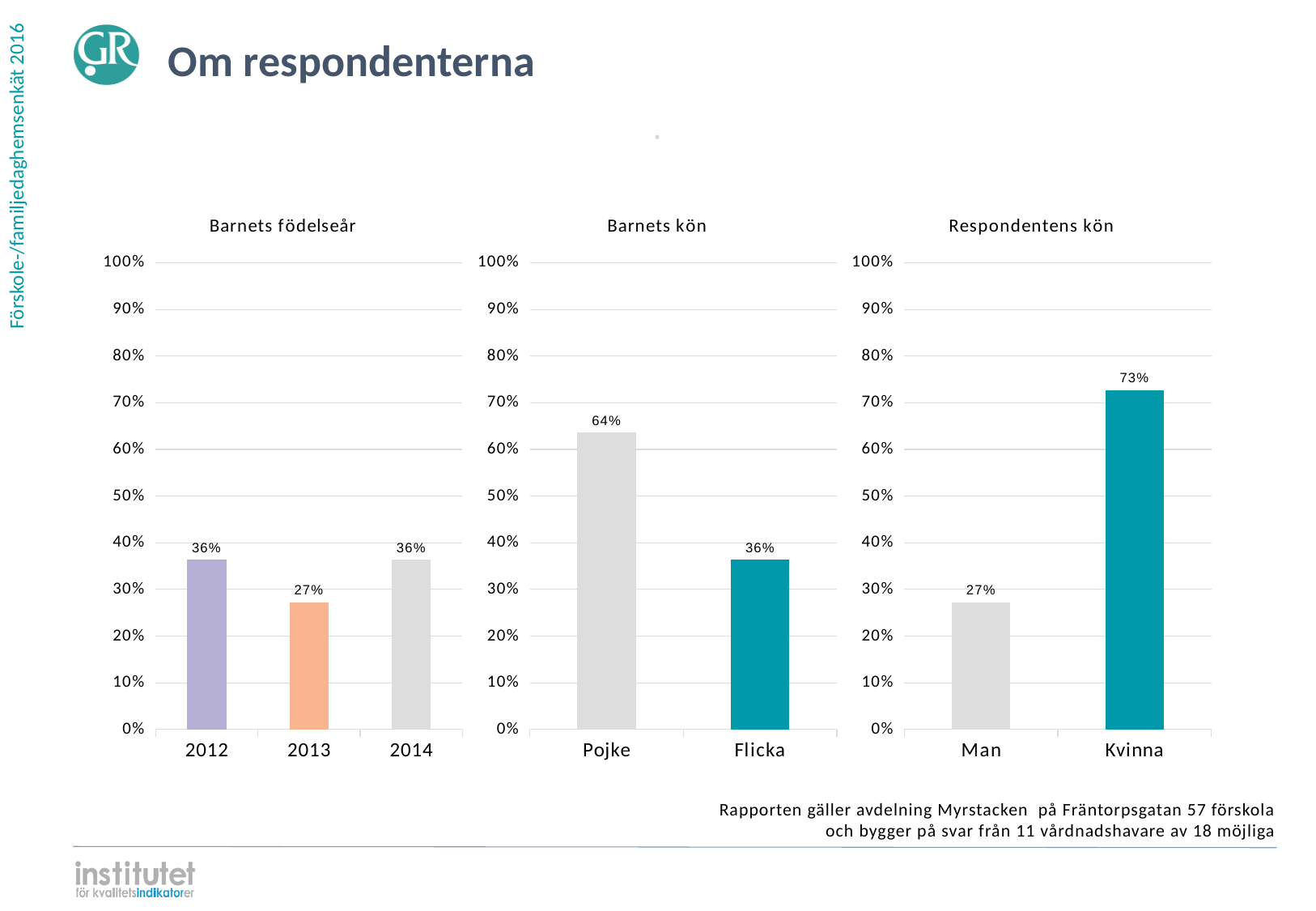
In the 'Barnets kön' chart, which category is higher, Pojke or Flicka? Pojke What is the title of the chart on the left of the slide? Barnets födelseår In the 'Respondentens kön' chart, what is the value for Kvinna? 73% In the 'Barnets kön' chart, what is the difference between Pojke and Flicka? 28% In the 'Barnets födelseår' chart, what is the value for 2013? 27% In the 'Respondentens kön' chart, is the value for Kvinna greater or less than 70%? greater In the 'Respondentens kön' chart, what is the value for Man? 27% In the 'Barnets födelseår' chart, how many categories are shown on the x axis? 3 In the 'Barnets födelseår' chart, which year has the lowest value? 2013 In the 'Barnets kön' chart, what is the value for Pojke? 64% What kind of chart is the 'Barnets kön' chart? Bar chart In the 'Respondentens kön' chart, which category has the highest value? Kvinna